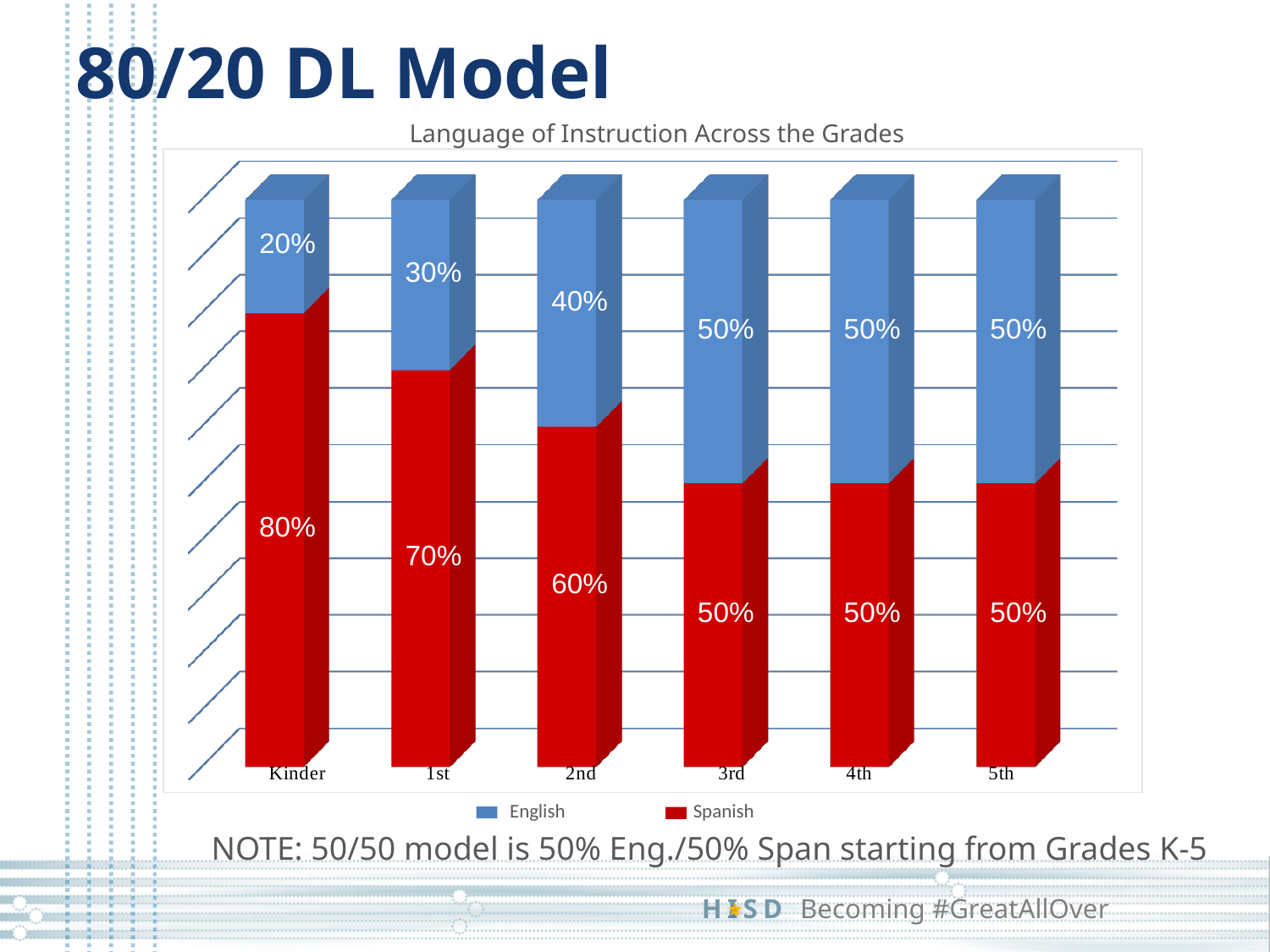
How many grade categories are shown on the x axis? 6 How many series does the legend list? 2 Which grade has the highest Spanish value? Kinder Which grade has the lowest English value? Kinder What is the English value for 2nd grade? 40% What is the English value for 1st grade? 30% What is the title of the chart? Language of Instruction Across the Grades What is the difference between the Spanish and English values for 1st grade? 40% What is the Spanish value for 4th grade? 50% Which is larger for 2nd grade, the English value or the Spanish value? Spanish What is the Spanish value for Kinder? 80% What kind of chart is shown? Stacked bar chart